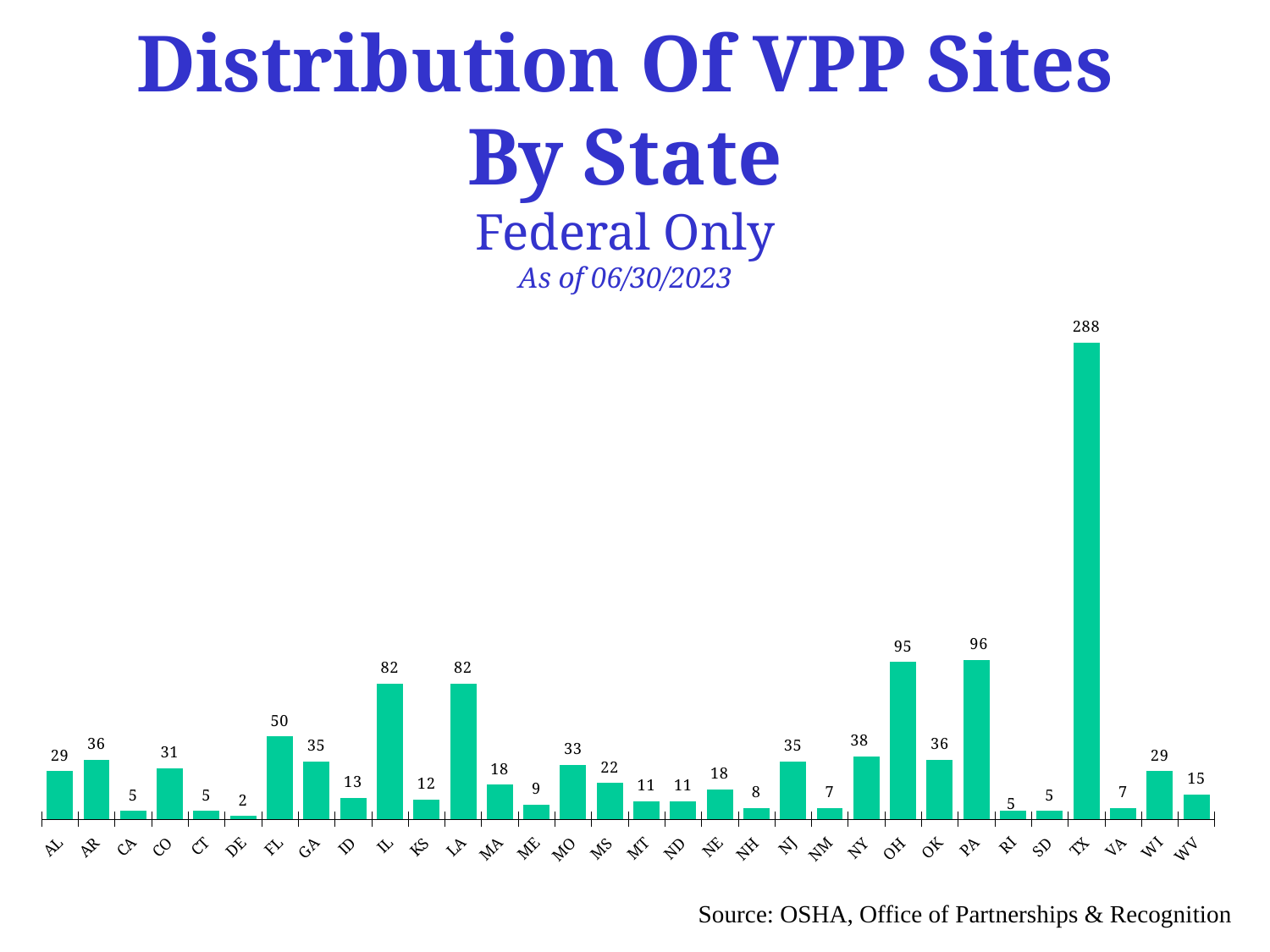
What is the value shown for Ohio (OH)? 95 Which has a larger value, IL or FL? IL How many VPP sites does Texas (TX) have? 288 What is the difference between the values for PA and OH? 1 What date is the data current as of, according to the subtitle? 06/30/2023 What is the value shown for Florida (FL)? 50 Which has a larger value, NY or NJ? NY What type of chart is shown on the slide? Bar chart What is the difference between the values for TX and PA? 192 How many states are shown on the x axis? 32 Which state has the lowest number of VPP sites? DE Which state has the highest number of VPP sites? TX